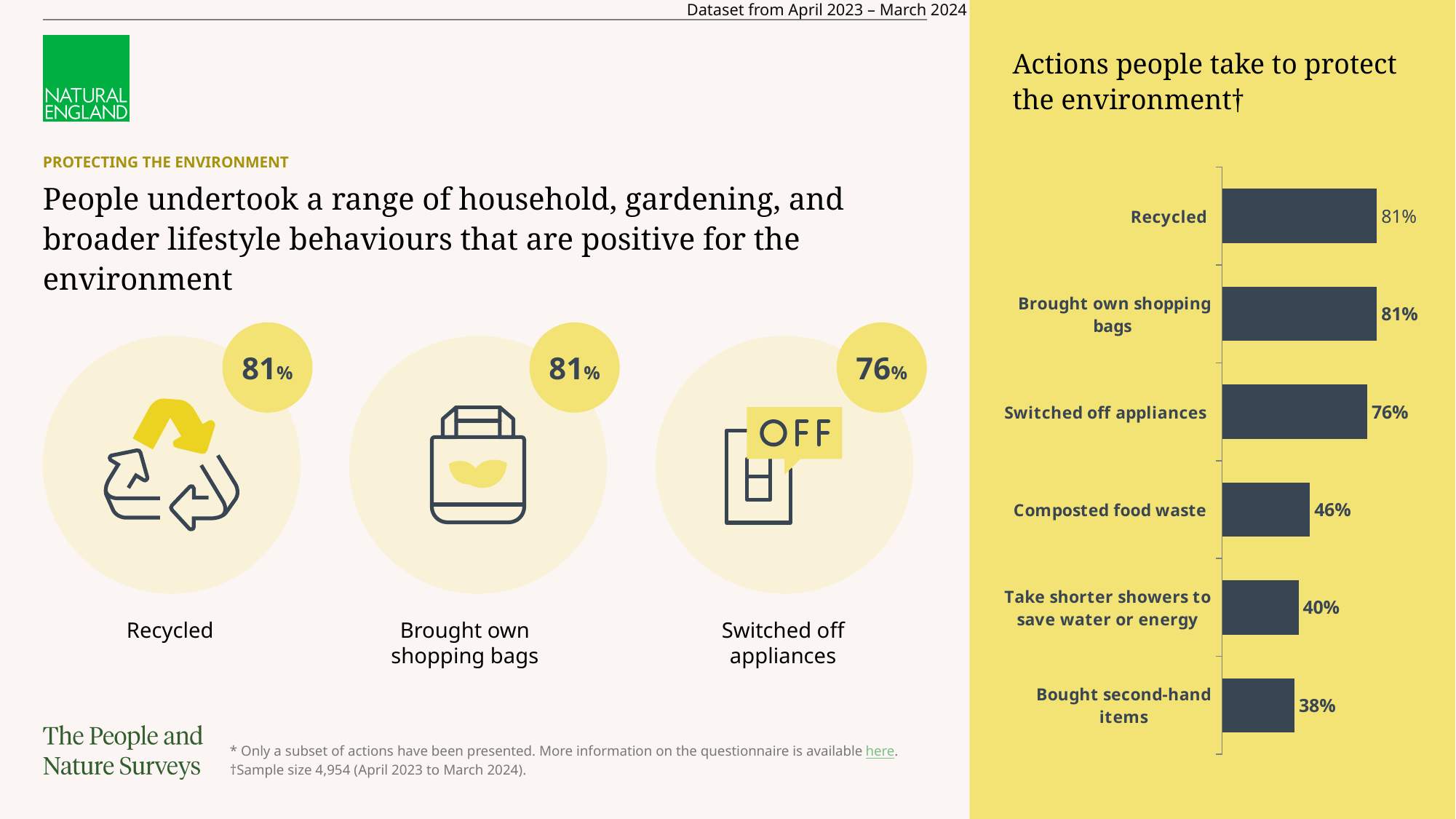
Do the values in the chart rise or fall from the top bar to the bottom bar? Fall What is the value for 'Take shorter showers to save water or energy' in the chart? 40% What percentage of people bought second-hand items? 38% What kind of chart is shown on the slide? Bar chart Which action has the lowest value in the chart? Bought second-hand items What is the difference between the values for 'Switched off appliances' and 'Composted food waste'? 30% What is the difference between the values for 'Recycled' and 'Bought second-hand items'? 43% What is the value for 'Switched off appliances' in the chart? 76% What is the title of the chart? Actions people take to protect the environment How many actions are shown in the chart? 6 What percentage of people composted food waste according to the chart? 46% Which is larger: the value for 'Composted food waste' or the value for 'Take shorter showers to save water or energy'? Composted food waste